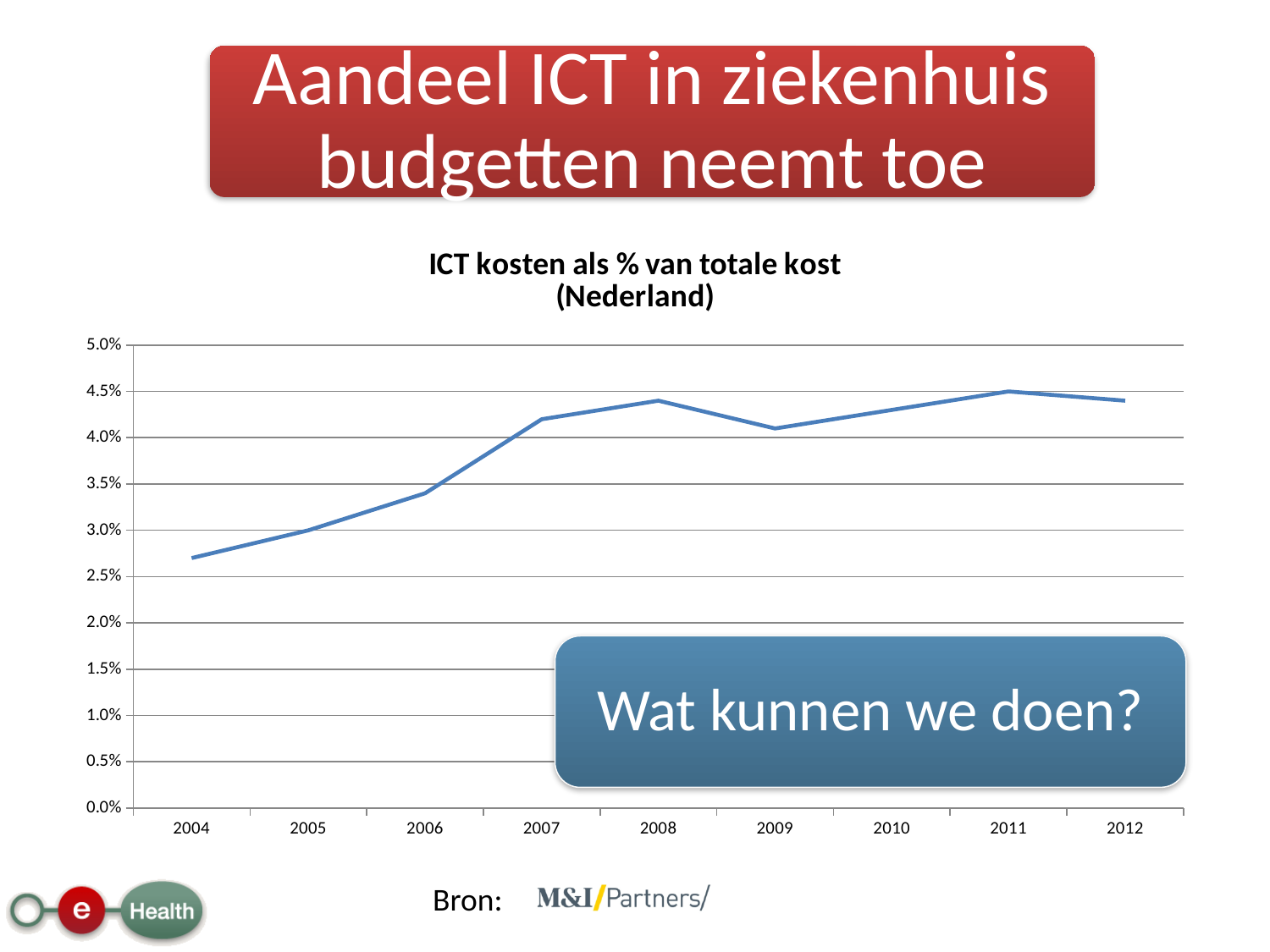
Which year has a higher value, 2004 or 2008? 2008 Is the value for 2006 greater or less than 3.0%? greater Which year has a higher value, 2009 or 2011? 2011 Is the value for 2009 greater or less than 4.5%? less Is the value for 2004 greater or less than 3.0%? less What is the title of the chart? ICT kosten als % van totale kost (Nederland) Which year has the lowest ICT cost share in the chart? 2004 Which year has the highest ICT cost share in the chart? 2011 How many years are plotted on the x axis of the chart? 9 What kind of chart is shown on the slide? line chart Does the ICT cost share generally rise or fall from 2004 to 2012? rise